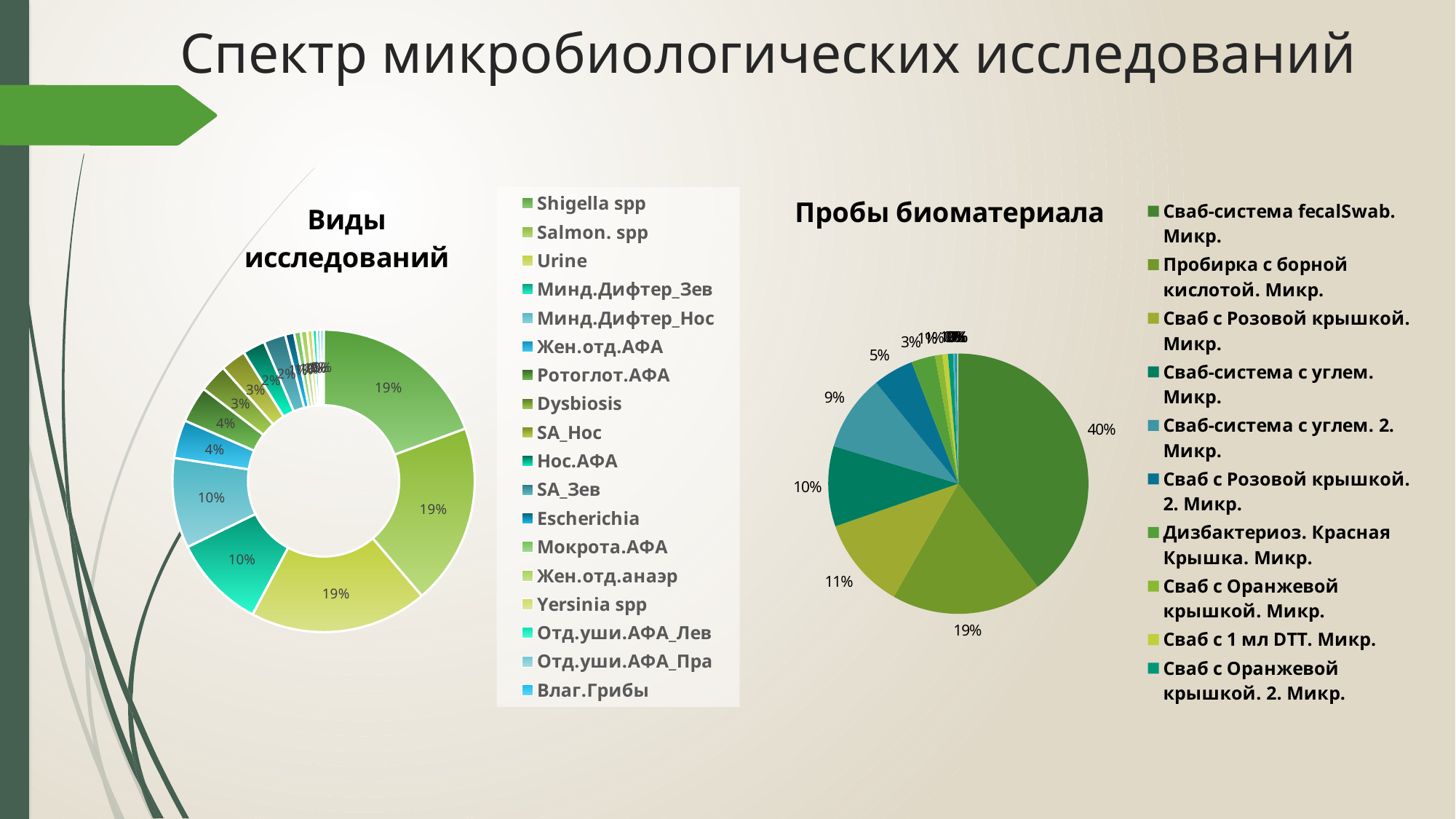
What kind of chart is the "Пробы биоматериала" chart? pie chart In the "Виды исследований" chart, what share does "Минд.Дифтер_Зев" have? 10% What is the title of the chart on the left of the slide? Виды исследований In the "Пробы биоматериала" chart, what share does "Пробирка с борной кислотой. Микр." have? 19% In the "Пробы биоматериала" chart, which is larger: "Сваб-система с углем. Микр." or "Сваб с Розовой крышкой. 2. Микр."? Сваб-система с углем. Микр. In the "Виды исследований" chart, which is larger: "Минд.Дифтер_Нос" or "Жен.отд.АФА"? Минд.Дифтер_Нос In the "Пробы биоматериала" chart, which category has the largest share? Сваб-система fecalSwab. Микр. In the "Виды исследований" chart, what share does "Shigella spp" have? 19% In the "Пробы биоматериала" chart, what share does "Сваб-система fecalSwab. Микр." have? 40% In the "Пробы биоматериала" chart, what is the difference between the shares of "Сваб-система fecalSwab. Микр." and "Пробирка с борной кислотой. Микр."? 21% How many categories does the legend of the "Пробы биоматериала" chart list? 10 How many categories does the legend of the "Виды исследований" chart list? 18